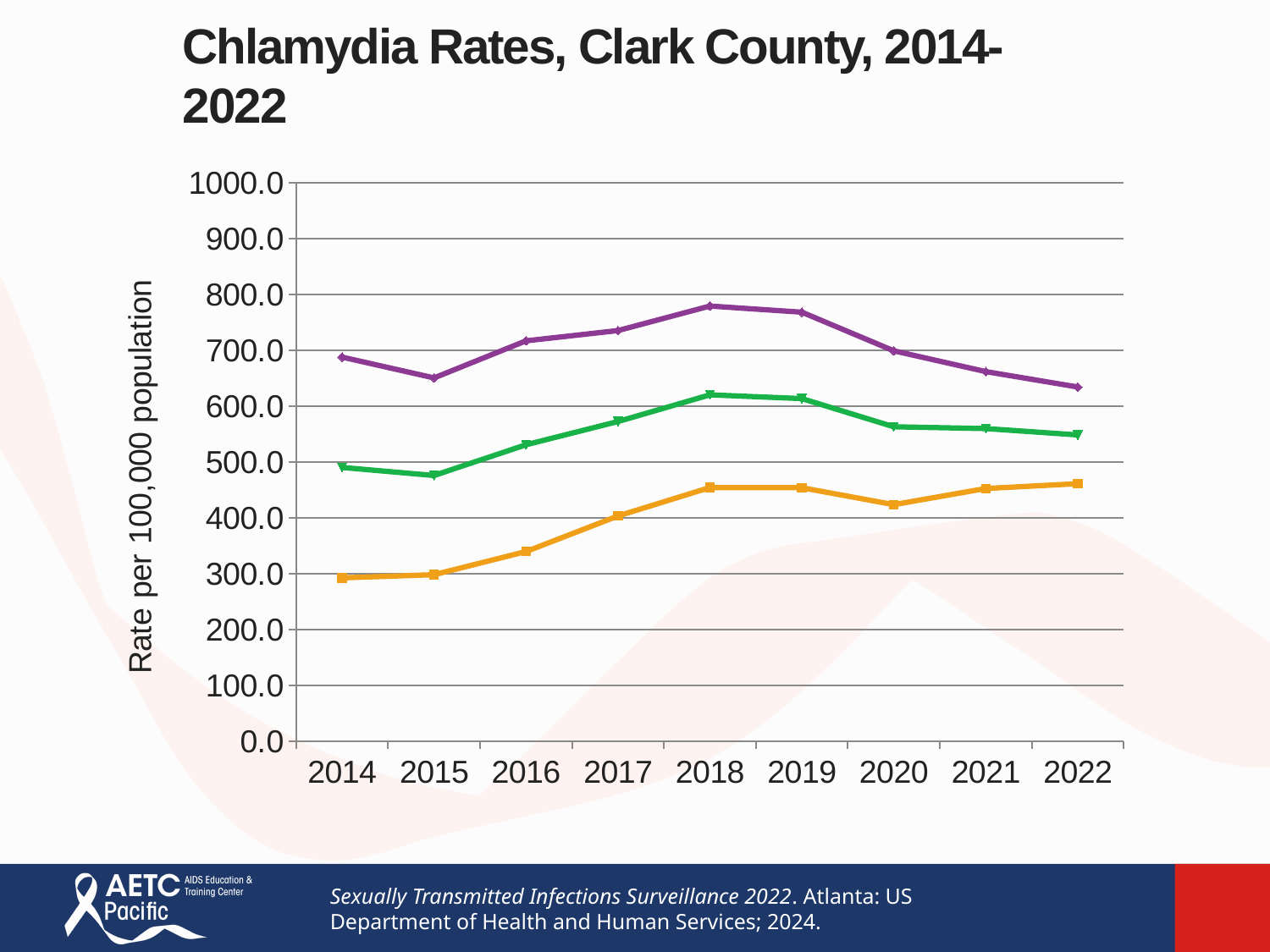
In 2018, which line has the higher value, the purple line or the green line? the purple line Is the value of the green line in 2018 greater or less than 600? greater What kind of chart is shown on the slide? line chart Is the value of the orange line in 2018 greater or less than 400? greater Is the value of the purple line in 2022 greater or less than 700? less Does the orange line rise or fall from 2014 to 2018? rise How many years are shown on the x axis of the chart? 9 What is the title of the chart on the slide? Chlamydia Rates, Clark County, 2014-2022 How many lines are plotted on the chart? 3 What is the label on the y axis of the chart? Rate per 100,000 population